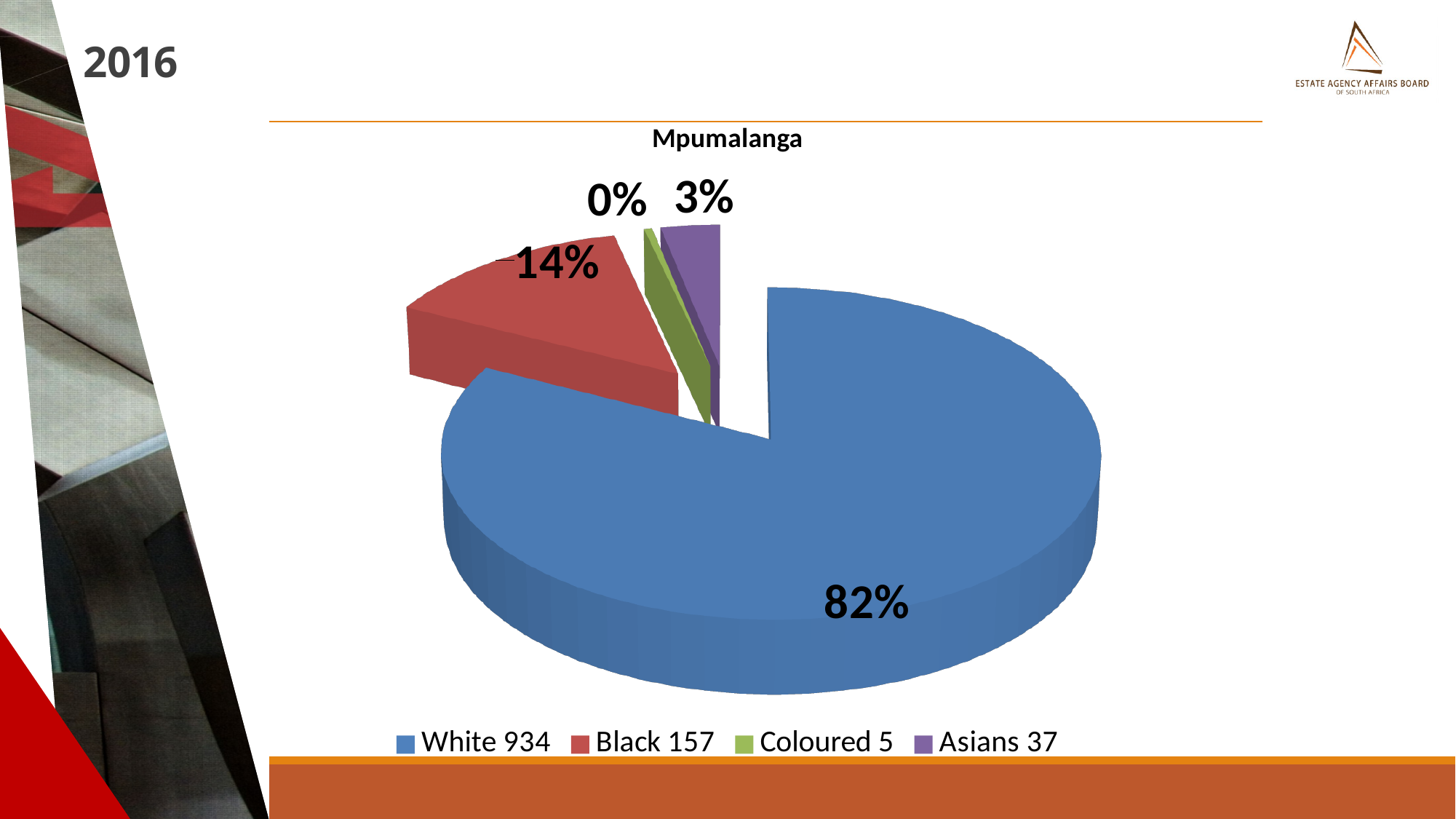
Which category has the smallest slice? Coloured What percentage share does the Asians slice have? 3% What percentage share does the Coloured slice have? 0% How many entries does the legend list? 4 What kind of chart is shown on the slide? pie chart Which colour represents the Black category in the pie chart? red Which category has the largest slice? White What percentage share does the White slice have? 82% What is the title of the chart? Mpumalanga What is the difference in percentage points between the White and Black slices? 68 How many slices does the pie chart have? 4